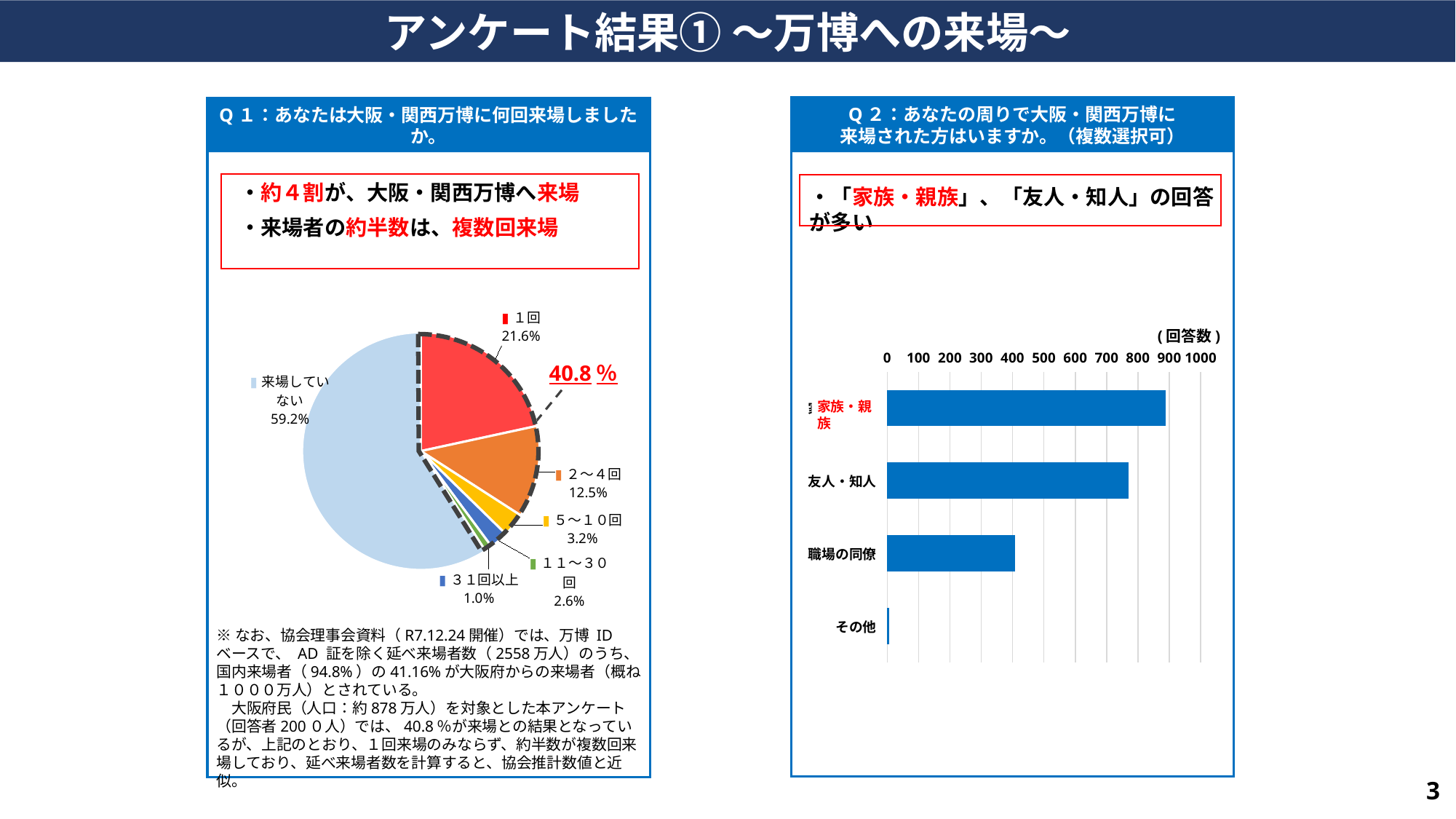
In the Q2 bar chart on the right, is the value for 友人・知人 greater or less than 700? greater In the Q2 bar chart on the right, which category has the lowest number of responses? その他 In the Q1 pie chart on the left, what percentage of respondents answered 1回? 21.6% In the Q1 pie chart on the left, what percentage of respondents answered 来場していない? 59.2% In the Q1 pie chart on the left, which category has the smallest share? 31回以上 In the Q2 bar chart on the right, which category has the highest number of responses? 家族・親族 In the Q1 pie chart on the left, which is larger, 5〜10回 or 11〜30回? 5〜10回 In the Q2 bar chart on the right, is the value for 職場の同僚 greater or less than 500? less In the Q1 pie chart on the left, what is the difference in percentage points between 1回 and 2〜4回? 9.1 In the Q1 pie chart on the left, what percentage of respondents answered 2〜4回? 12.5% In the Q1 pie chart on the left, how many slices does the pie have? 6 What type of chart is shown in the Q2 panel on the right? Bar chart